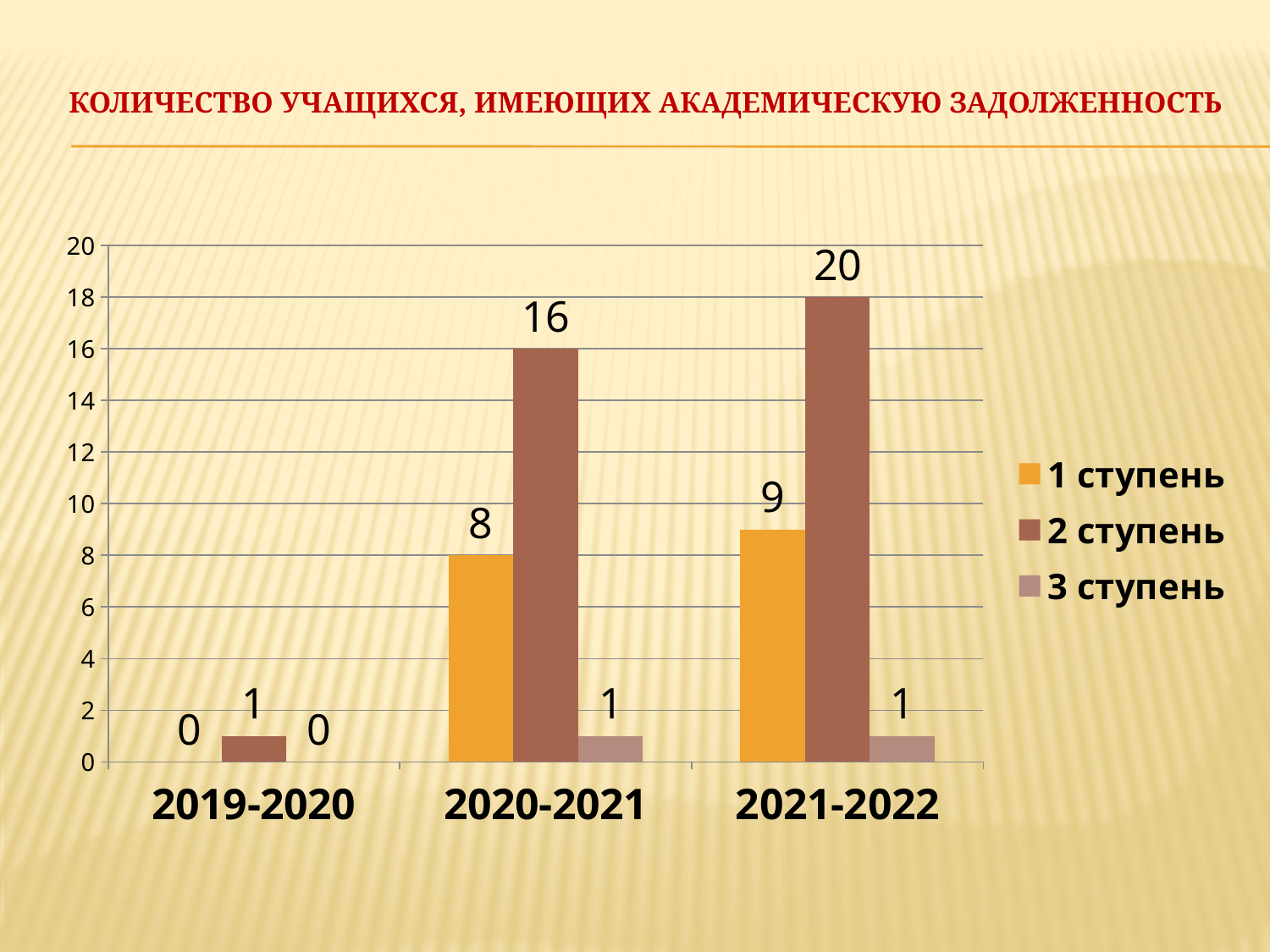
Does the value for 1 ступень rise or fall from 2019-2020 to 2021-2022? rise What type of chart is shown on the slide? bar chart Which is larger in 2020-2021: the value for 1 ступень or for 3 ступень? 1 ступень What is the difference between the 2 ступень values for 2021-2022 and 2020-2021? 4 What is the value for 3 ступень in 2019-2020? 0 In which academic year is the value for 1 ступень lowest? 2019-2020 What is the value for 1 ступень in 2021-2022? 9 In which academic year is the value for 2 ступень highest? 2021-2022 What is the value for 2 ступень in 2019-2020? 1 What is the value for 2 ступень in 2020-2021? 16 How many series does the legend list? 3 How many academic-year categories are shown on the x axis? 3